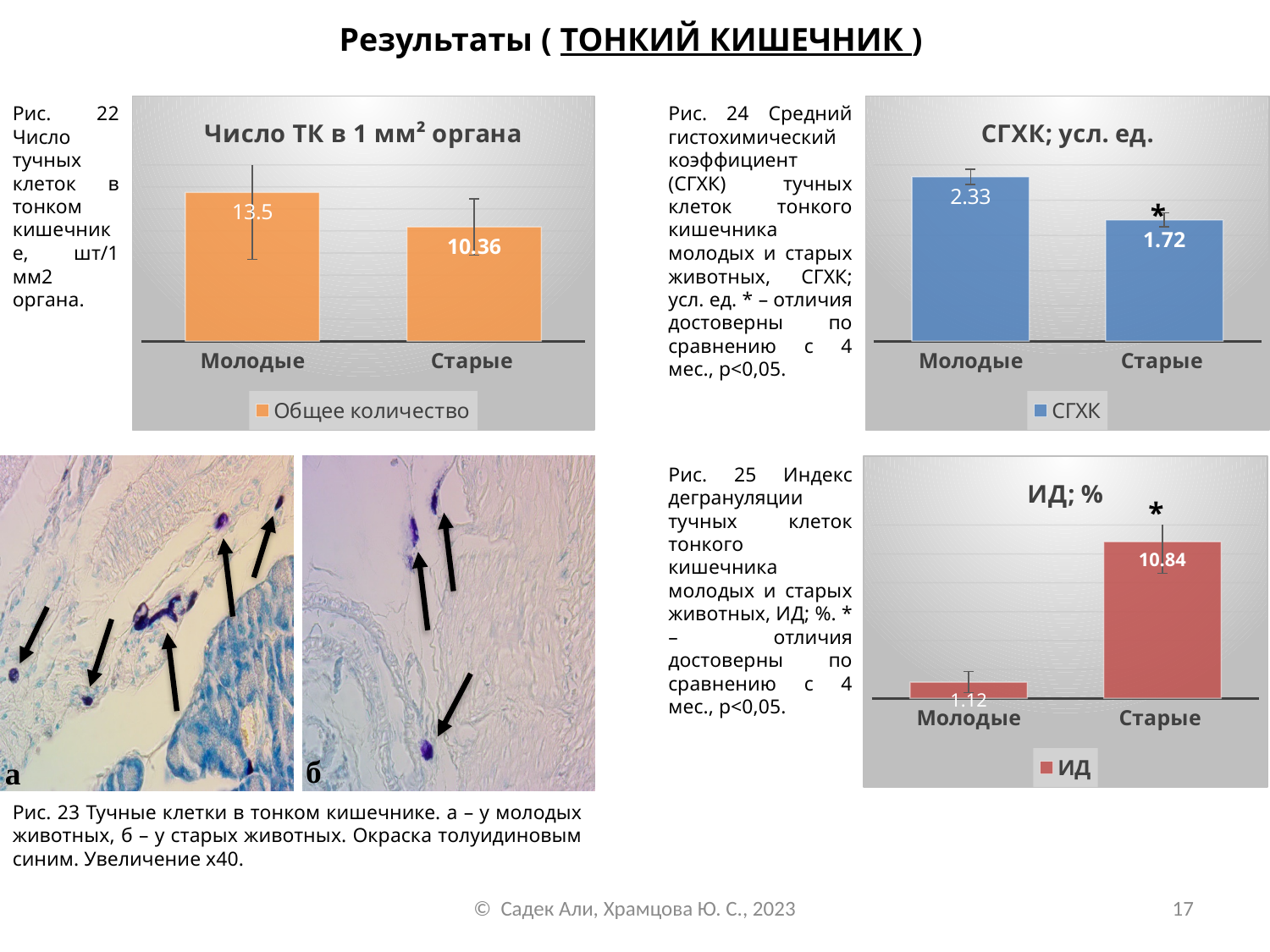
In the chart titled "Число ТК в 1 мм² органа", what is the difference between the values for Молодые and Старые? 3.14 In the chart titled "ИД; %", what is the value for Молодые? 1.12 In the chart titled "СГХК; усл. ед.", what is the value for Молодые? 2.33 In the chart titled "СГХК; усл. ед.", what is the value for Старые? 1.72 In the chart titled "ИД; %", which is larger, the value for Молодые or the value for Старые? Старые What type of chart is the chart titled "СГХК; усл. ед."? Bar chart In the chart titled "ИД; %", what is the difference between the values for Старые and Молодые? 9.72 In the chart titled "СГХК; усл. ед.", which category has the lower value? Старые In the chart titled "Число ТК в 1 мм² органа", what is the value for Старые? 10.36 In the chart titled "Число ТК в 1 мм² органа", which category has the higher value? Молодые In the chart titled "Число ТК в 1 мм² органа", what is the value for Молодые? 13.5 In the chart titled "ИД; %", what is the value for Старые? 10.84